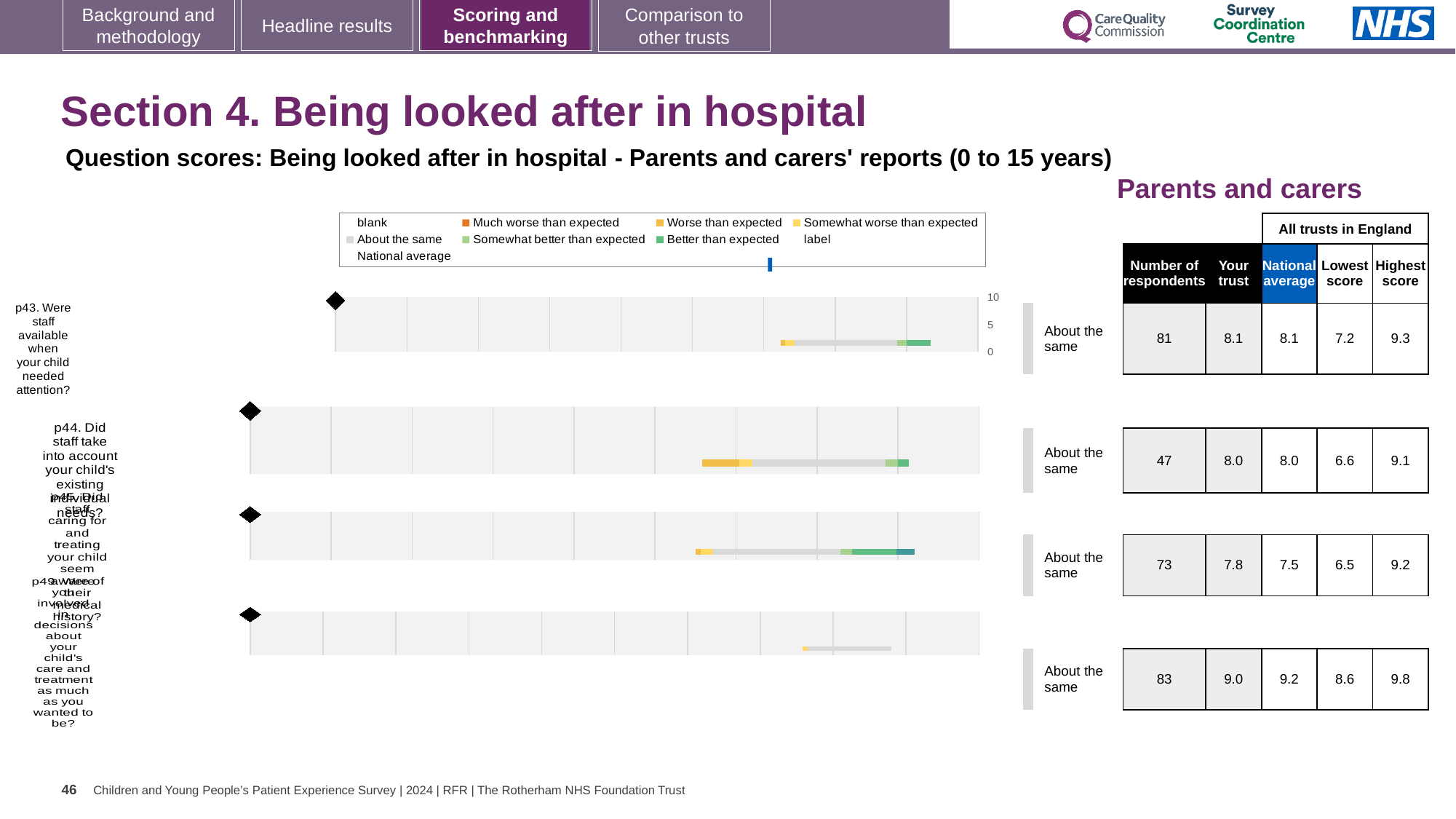
How many questions are plotted on this slide? 4 What is the highest score among all trusts in England for p49 (Were you involved in decisions about your child's care and treatment as much as you wanted to be?)? 9.8 For p45, what is the difference between the 'Your trust' score and the national average? 0.3 What benchmark category is shown for p43 (Were staff available when your child needed attention?)? About the same How many respondents answered p44 (Did staff take into account your child's existing individual needs?)? 47 What is the national average score for p45 (Did staff caring for and treating your child seem aware of their medical history?)? 7.5 Which question has the highest 'Your trust' score? p49 What is the lowest score among all trusts in England for p44? 6.6 For p49, which is larger: the 'Your trust' score or the national average? National average Which question has the lowest 'Lowest score' value across all trusts in England? p45 What kind of chart is used to show the question scores on this slide? Bar chart What is the 'Your trust' score for p43 (Were staff available when your child needed attention?)? 8.1